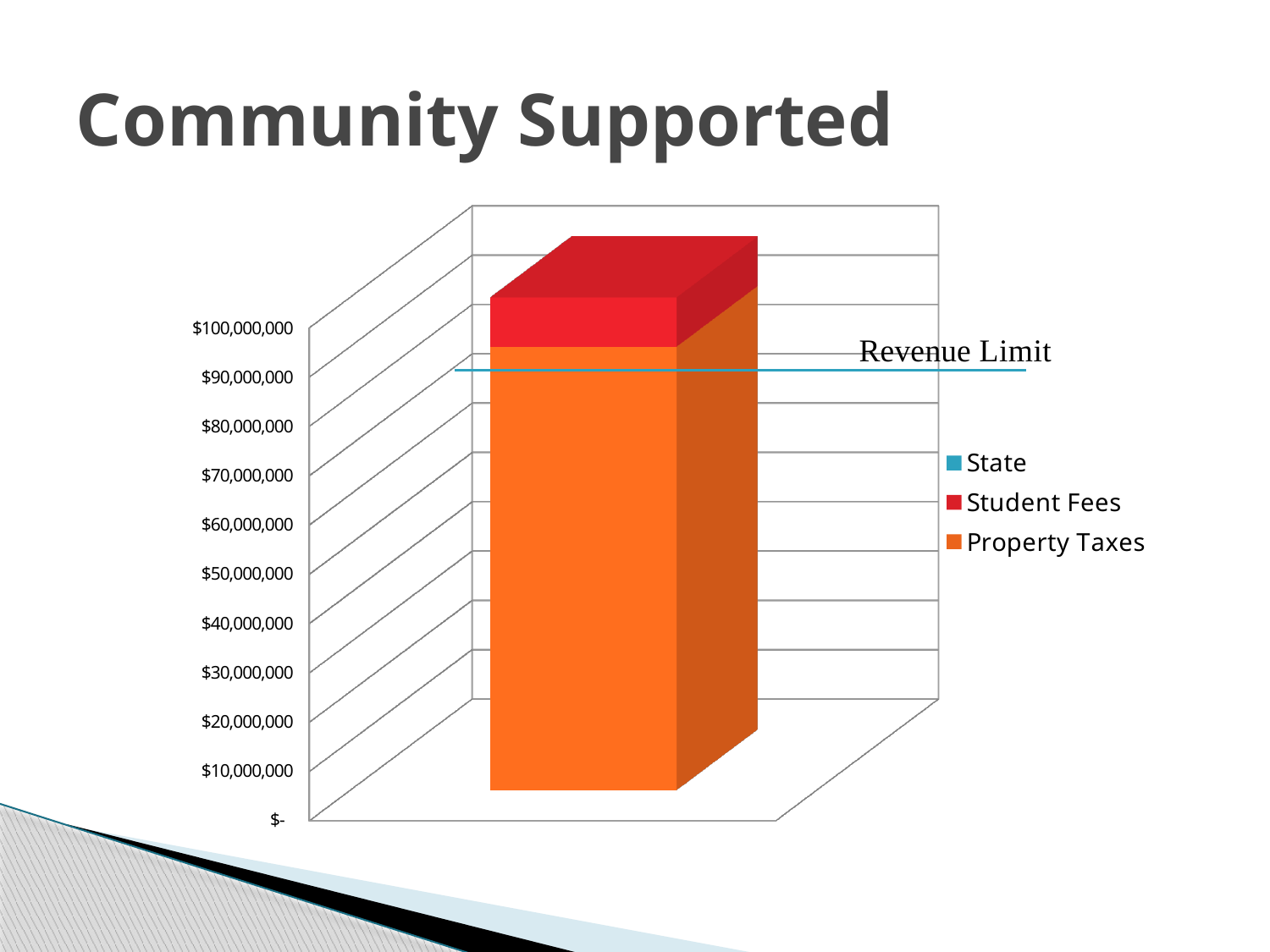
What kind of chart is shown on the slide? Stacked bar chart Which series has the largest segment in the bar? Property Taxes Which segment is larger, Property Taxes or Student Fees? Property Taxes Is the value for Student Fees greater or less than $50,000,000? less How many bars are plotted in the chart? 1 Which series is shown in red in the legend? Student Fees Is the value for Property Taxes greater or less than $50,000,000? greater How many series does the legend list? 3 Is the total height of the stacked bar greater or less than $50,000,000? greater What is the label on the horizontal line drawn across the chart? Revenue Limit